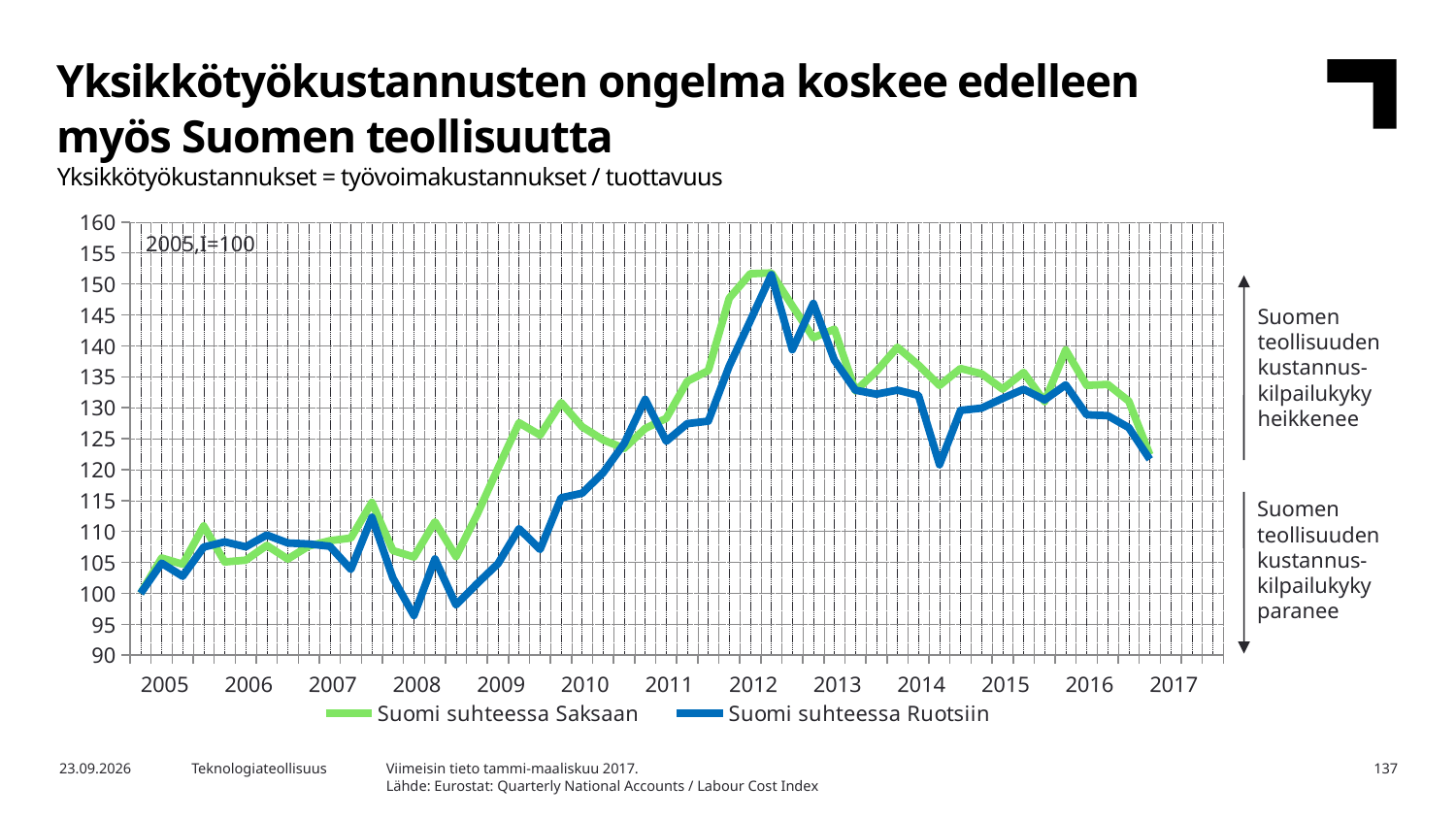
In which year does the Suomi suhteessa Saksaan series reach its highest value? 2012 Do the two series rise or fall between 2012 and 2017? fall In 2009, which series has the higher value, Suomi suhteessa Saksaan or Suomi suhteessa Ruotsiin? Suomi suhteessa Saksaan Is the peak value of the Suomi suhteessa Saksaan series in 2012 greater or less than 150? greater In which year does the Suomi suhteessa Ruotsiin series reach its lowest value? 2008 Is the value of the Suomi suhteessa Ruotsiin series at its 2014 dip greater or less than 125? less What is the index base stated on the chart? 2005,I=100 What are the two series named in the legend? Suomi suhteessa Saksaan; Suomi suhteessa Ruotsiin What kind of chart is shown on the slide? line chart Is the lowest value of the Suomi suhteessa Ruotsiin series in 2008 greater or less than 100? less What is the value of both series at the start of 2005? 100 How many series does the legend list? 2